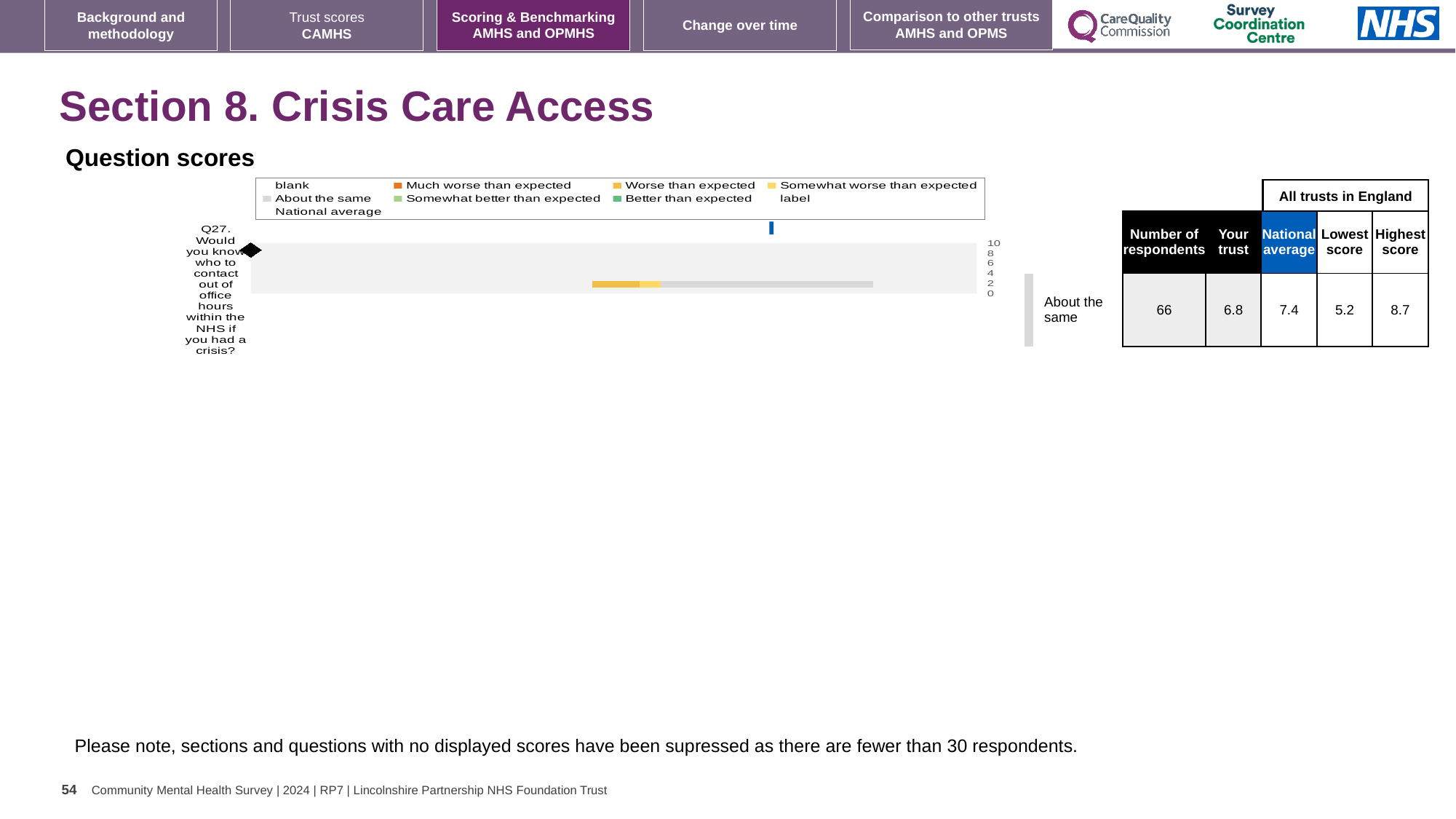
For Q27, which is larger: the 'Your trust' score or the National average? National average By how much does the National average exceed the 'Your trust' score for Q27? 0.6 How many questions are plotted in the Question scores chart? 1 What is the title of the section shown on this slide? Section 8. Crisis Care Access What is the difference between the Highest score and the Lowest score for Q27? 3.5 What is the 'Your trust' score for Q27? 6.8 How many respondents answered Q27? 66 Which benchmark category is shown for Q27 (Would you know who to contact out of office hours within the NHS if you had a crisis?)? About the same What kind of chart is used to show the Q27 question score? Bar chart What is the Highest score among all trusts in England for Q27? 8.7 What is the National average score for Q27? 7.4 What is the Lowest score among all trusts in England for Q27? 5.2